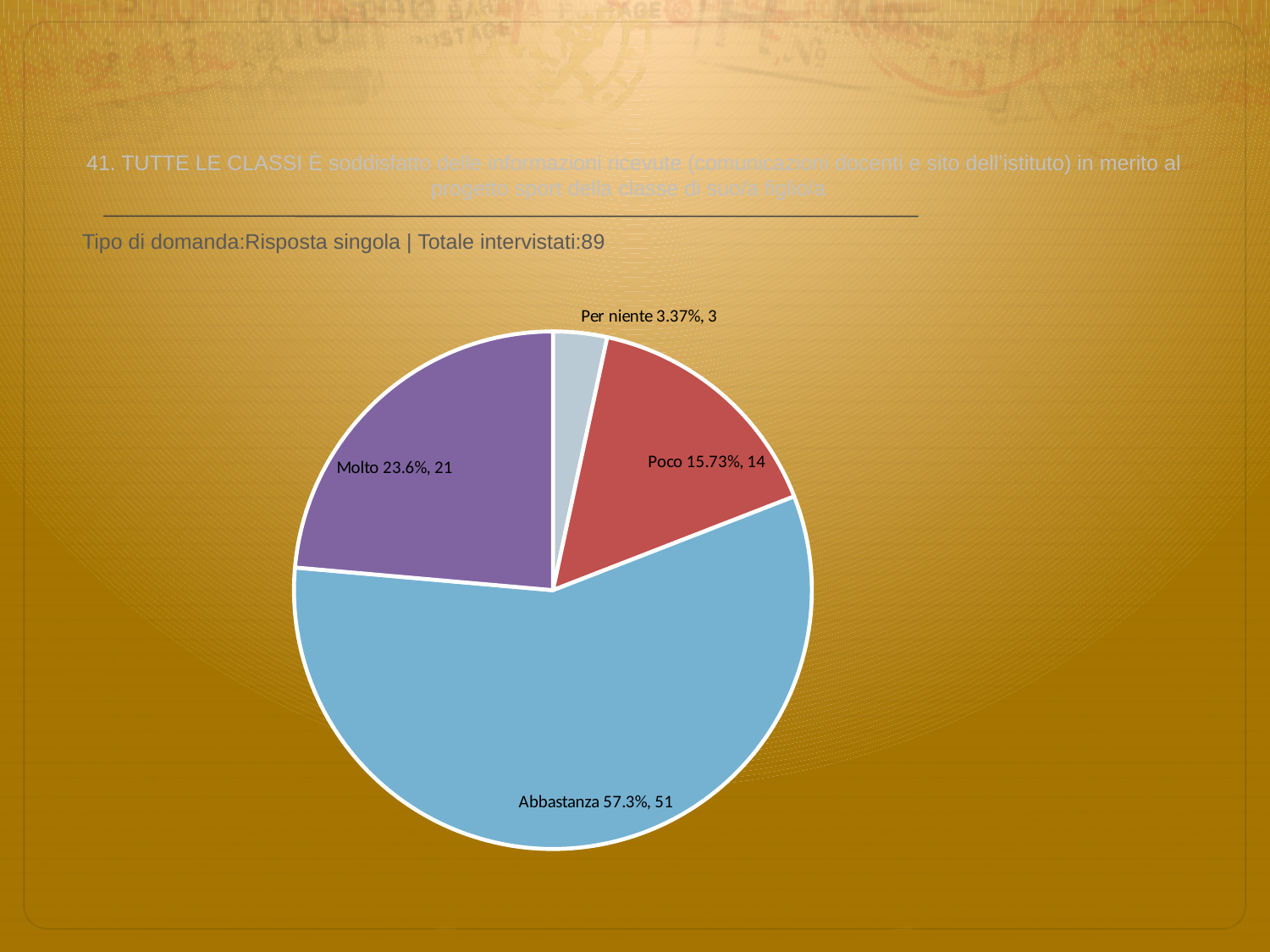
Which category has the smallest slice of the pie? Per niente How many respondents answered Molto? 21 Which category has the largest slice of the pie? Abbastanza Which slice is larger, Molto or Poco? Molto What is the total number of respondents across all slices? 89 How many respondents answered Per niente? 3 What kind of chart is shown on the slide? pie chart What is the difference in respondent count between Abbastanza and Molto? 30 What percentage is shown for the Abbastanza slice? 57.3% What percentage is shown for the Poco slice? 15.73% How many slices does the pie chart have? 4 What colour is the Abbastanza slice? blue